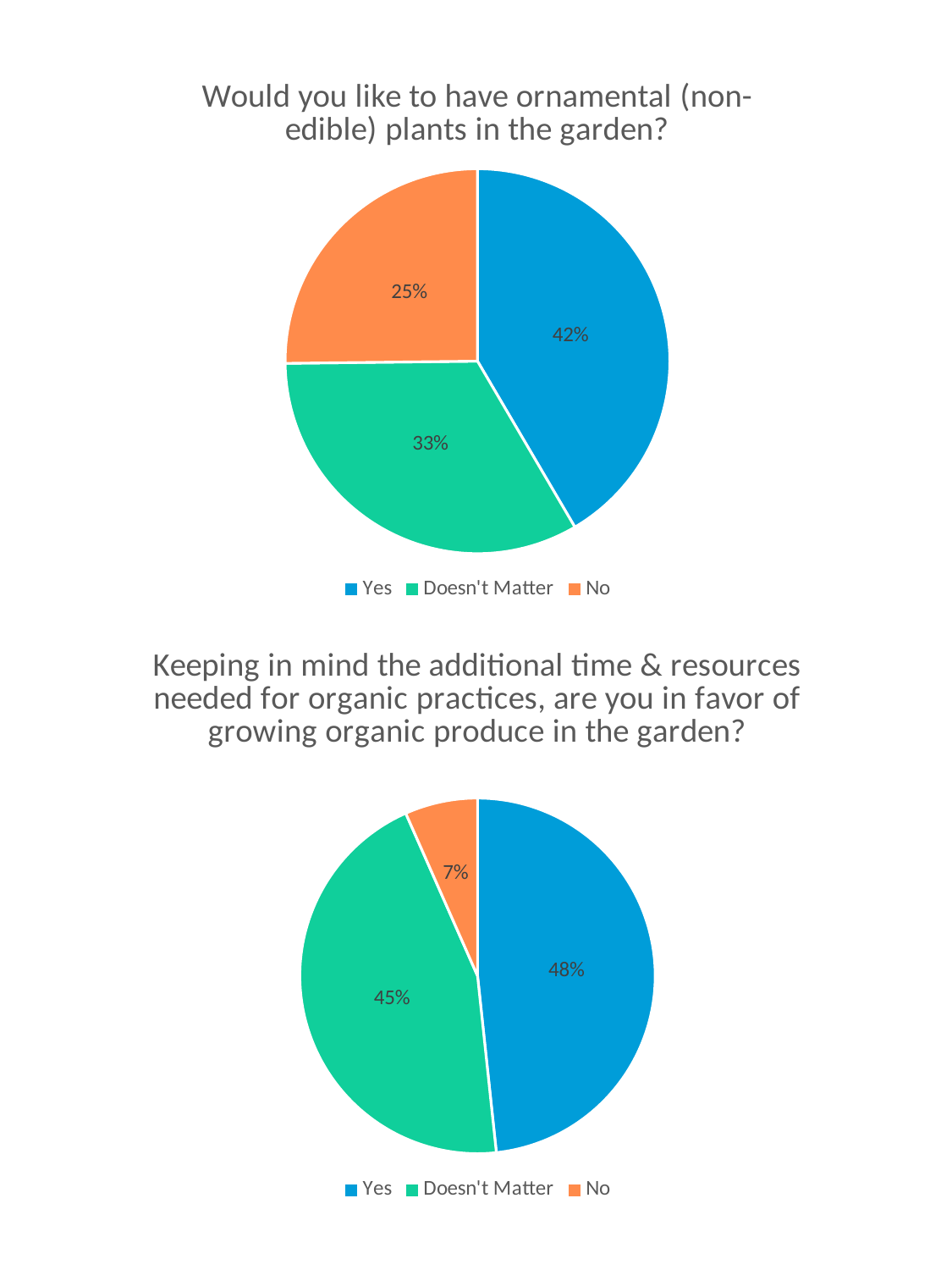
In the top chart (ornamental plants), what share of responses is 'No'? 25% In the bottom chart (organic produce), which is larger: 'Yes' or 'Doesn't Matter'? Yes In the bottom chart (organic produce), what is the difference between the 'Yes' and 'No' shares? 41% What type of chart is the top chart (ornamental plants)? Pie chart In the top chart (ornamental plants), what is the difference between the 'Yes' and 'Doesn't Matter' shares? 9% In the bottom chart (organic produce), which response has the smallest share? No In the bottom chart (organic produce), what share of responses is 'Doesn't Matter'? 45% In the bottom chart (organic produce), what share of responses is 'No'? 7% In the top chart (ornamental plants), which response has the largest share? Yes In the top chart (ornamental plants), which response has the smallest share? No In the top chart (ornamental plants), what share of responses is 'Yes'? 42% How many categories does the legend of the bottom chart (organic produce) list? 3